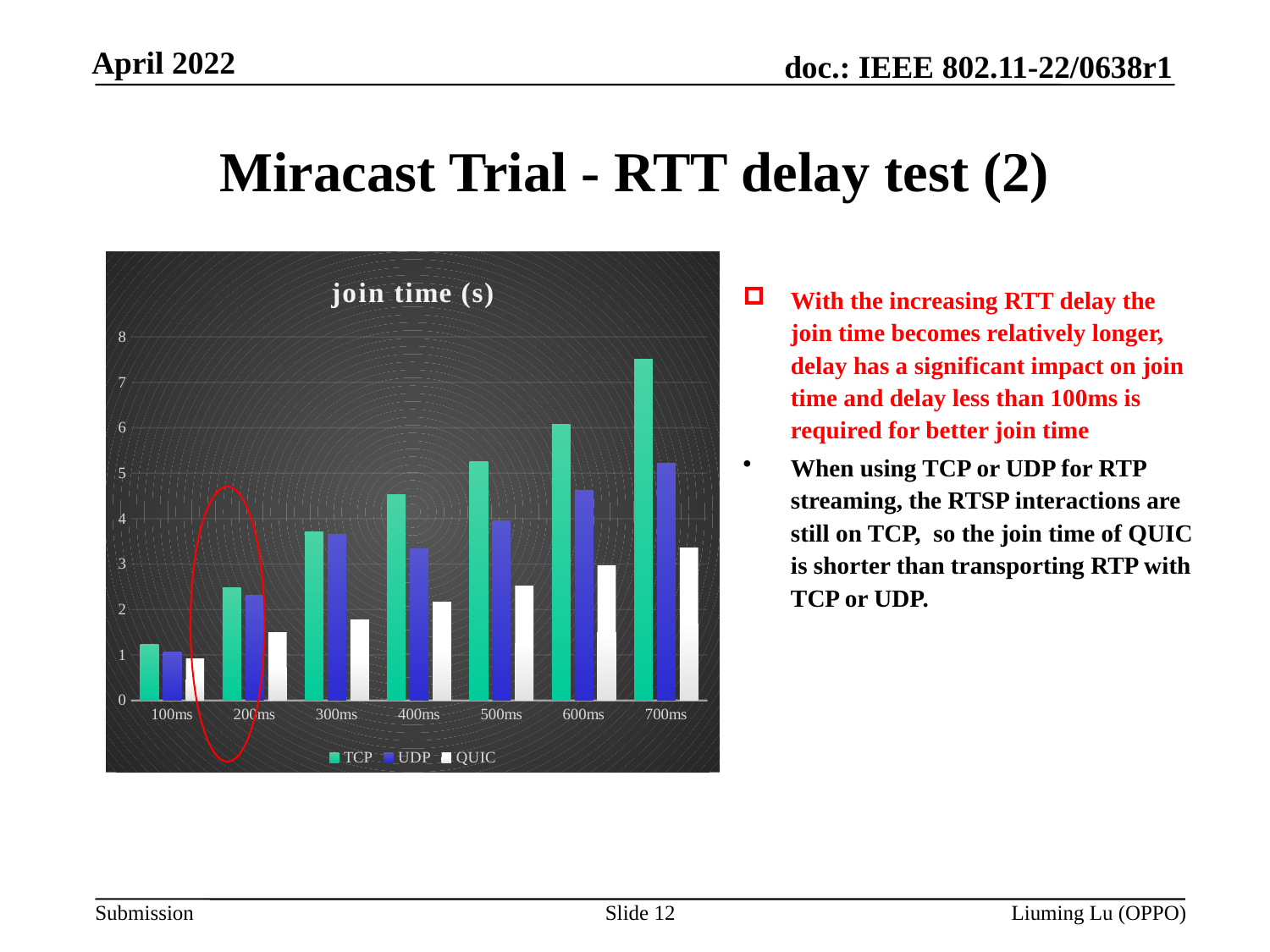
At which RTT delay is the QUIC join time lowest? 100ms Is the TCP join time at 700ms greater or less than 7? greater What is the title of the chart? join time (s) At 500ms, which has the larger join time, TCP or QUIC? TCP At which RTT delay is the TCP join time highest? 700ms Is the QUIC join time at 100ms greater or less than 1? less Do the join times rise or fall as the RTT delay increases along the x axis? rise Is the TCP join time at 400ms greater or less than 4? greater Which series are listed in the chart legend? TCP, UDP, QUIC How many RTT delay categories are shown on the x axis? 7 What kind of chart is shown on the slide? bar chart How many series does the chart legend list? 3